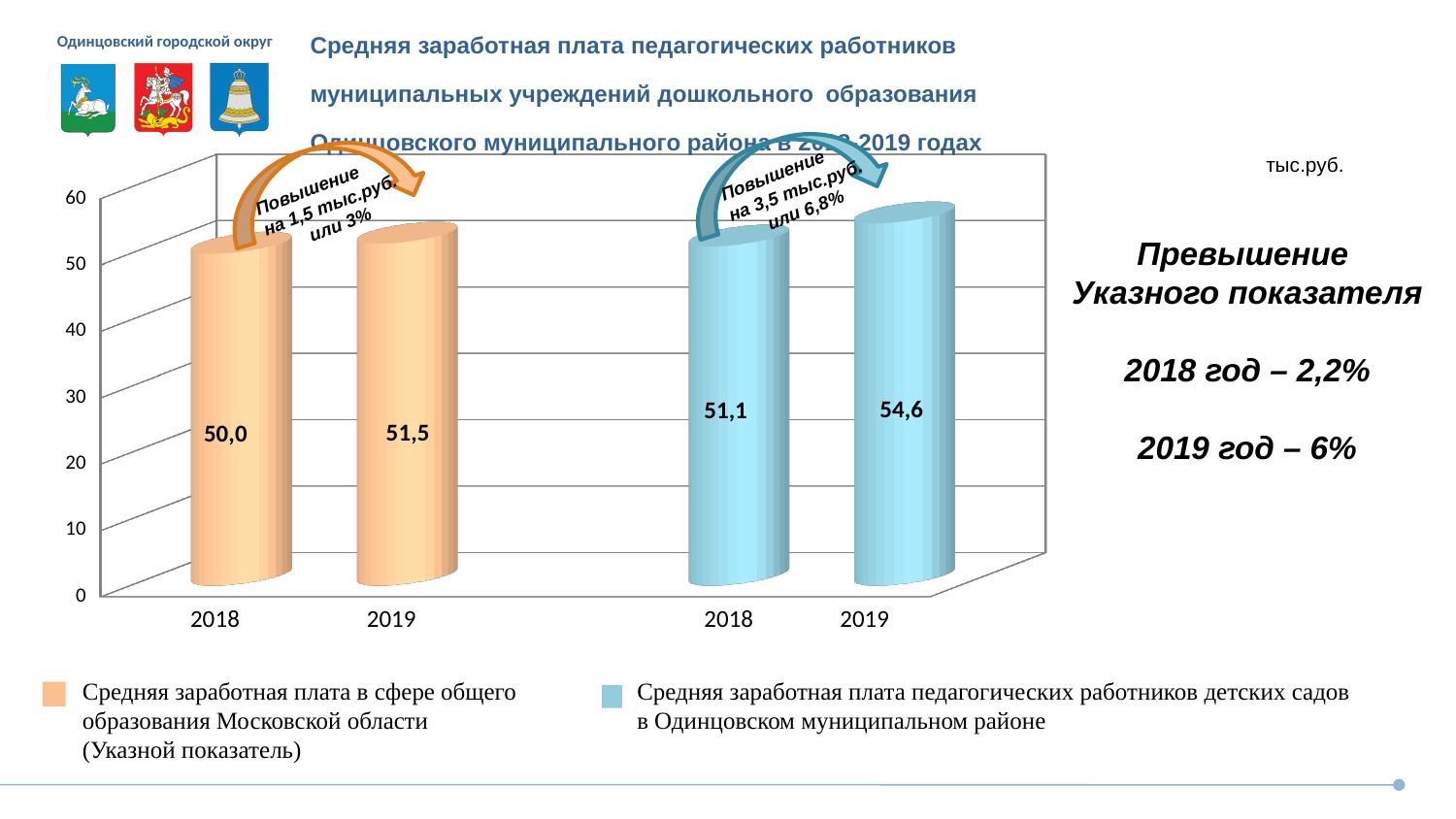
What is the value for 2019 for the orange series (Указной показатель)? 51,5 What is the value for 2018 for the blue series (педагогических работников детских садов в Одинцовском муниципальном районе)? 51,1 What is the difference between the 2019 and 2018 values for the orange series (Указной показатель)? 1,5 Which bar has the lowest value on the chart? 2018, Указной показатель (50,0) Which is larger in 2019: the Указной показатель or the value for педагогических работников детских садов в Одинцовском муниципальном районе? педагогических работников детских садов в Одинцовском муниципальном районе (54,6) What kind of chart is shown on the slide? Bar chart What is the difference between the 2019 and 2018 values for the blue series (Одинцовский муниципальный район)? 3,5 What is the value for 2019 for the blue series (педагогических работников детских садов в Одинцовском муниципальном районе)? 54,6 Do the values for the blue series rise or fall from 2018 to 2019? Rise How many series does the legend list? 2 Which bar has the highest value on the chart? 2019, педагогических работников детских садов в Одинцовском муниципальном районе (54,6) What is the value for 2018 for the orange series (Средняя заработная плата в сфере общего образования Московской области, Указной показатель)? 50,0